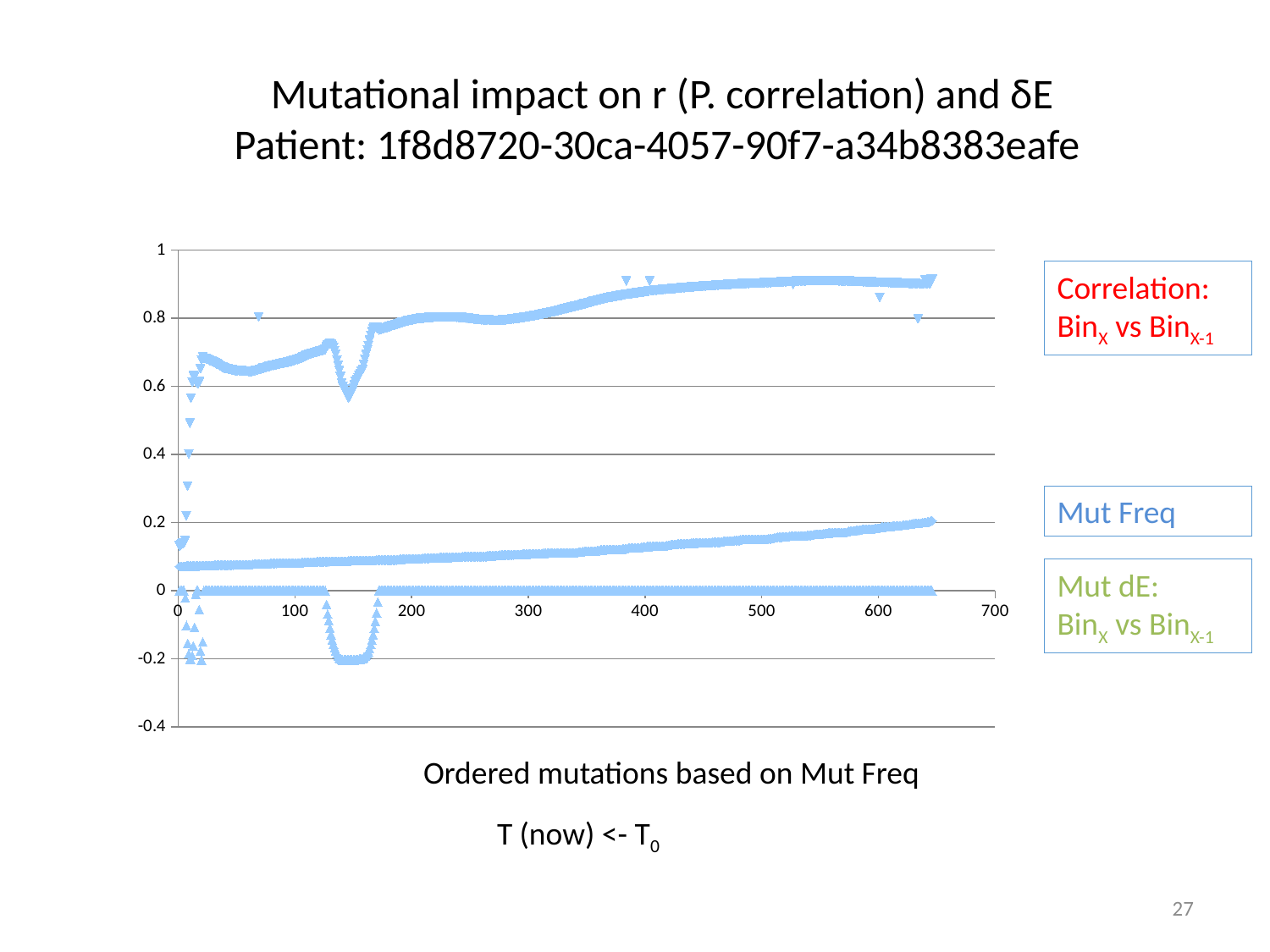
What is the label of the x axis below the chart? Ordered mutations based on Mut Freq At x = 300, which series has the larger value, Correlation or Mut Freq? Correlation Is the Correlation value at x = 500 greater or less than 0.8? greater What kind of chart is shown on the slide? scatter chart Is the Mut dE value at x = 150 greater or less than 0? less How many data series are labelled beside the chart? 3 Does the Mut Freq series rise or fall as the x axis increases from 0 to 650? rise Is the Mut Freq value at x = 600 greater or less than 0.2? less What is the highest value shown on the y axis? 1 Which of the three series has the lowest values overall on the chart? Mut dE Which of the three series has the highest values overall on the chart? Correlation